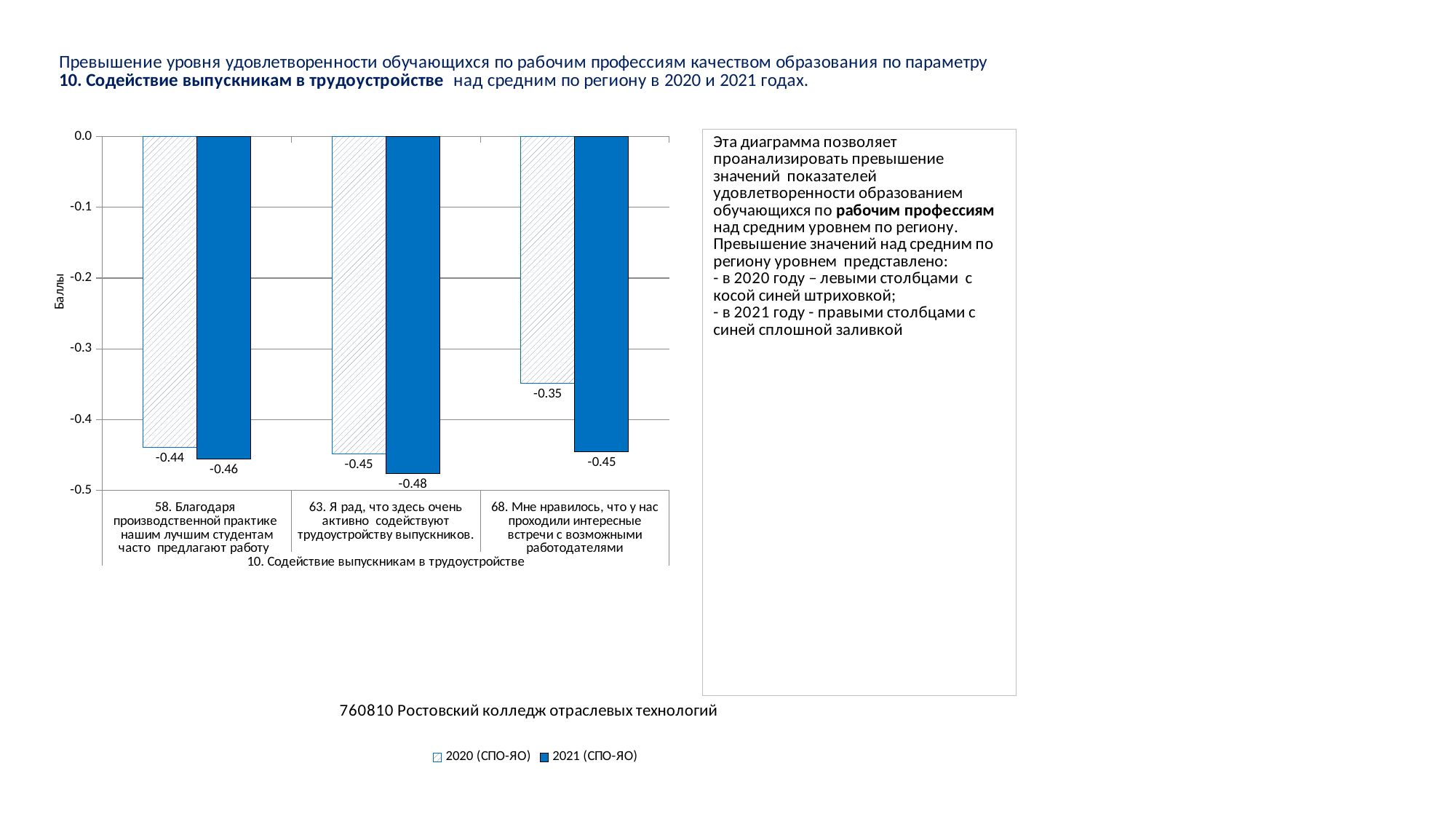
What is the difference between the 2020 (СПО-ЯО) and 2021 (СПО-ЯО) values for category 68? 0.10 How many categories are shown on the x axis of the chart? 3 What is the value for 2021 (СПО-ЯО) for category 63 (Я рад, что здесь очень активно содействуют трудоустройству выпускников)? -0.48 For category 58, which is larger: the 2020 (СПО-ЯО) value or the 2021 (СПО-ЯО) value? 2020 (СПО-ЯО) What type of chart is shown on the slide? bar chart What is the value for 2021 (СПО-ЯО) for category 68? -0.45 What is the value for 2020 (СПО-ЯО) for category 58 (Благодаря производственной практике наши лучшим студентам часто предлагают работу)? -0.44 What is the value for 2020 (СПО-ЯО) for category 68 (Мне нравилось, что у нас проходили интересные встречи с возможными работодателями)? -0.35 Which category has the highest value for 2020 (СПО-ЯО)? 68. Мне нравилось, что у нас проходили интересные встречи с возможными работодателями What is the label of the y axis of the chart? Баллы How many series does the legend list? 2 Which category has the lowest value for 2021 (СПО-ЯО)? 63. Я рад, что здесь очень активно содействуют трудоустройству выпускников.